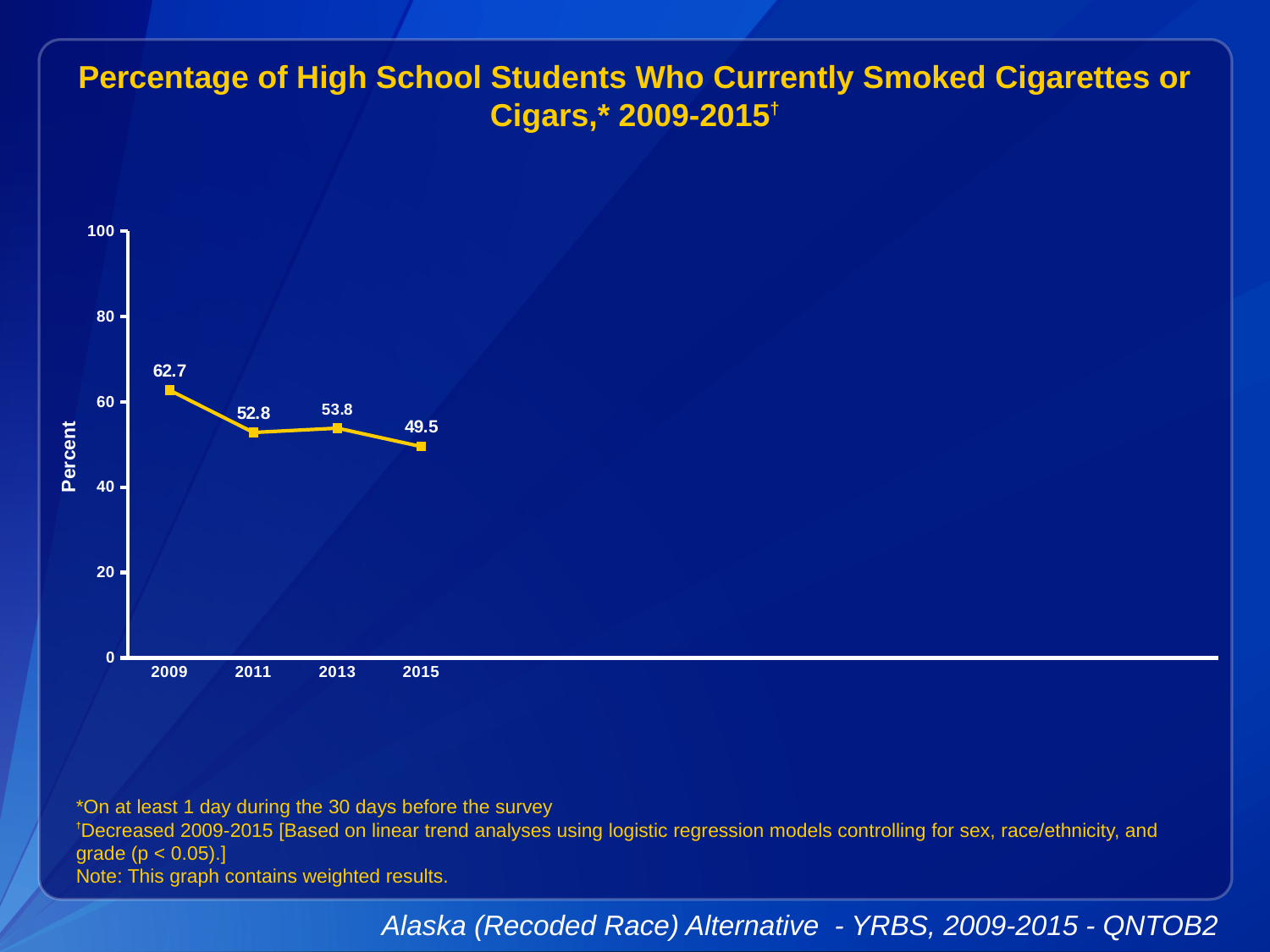
What was the percentage of high school students who currently smoked cigarettes or cigars in 2015? 49.5 Which year has the lowest percentage? 2015 Is the value for 2009 greater or less than 60? greater Which year has a larger value, 2011 or 2013? 2013 Which year has the highest percentage? 2009 Do the values generally rise or fall from 2009 to 2015? fall What value is shown for 2011? 52.8 What was the percentage of high school students who currently smoked cigarettes or cigars in 2009? 62.7 What kind of chart is shown on the slide? line chart How many years are plotted on the chart? 4 What is the label on the y axis? Percent What is the difference between the 2009 value and the 2015 value? 13.2